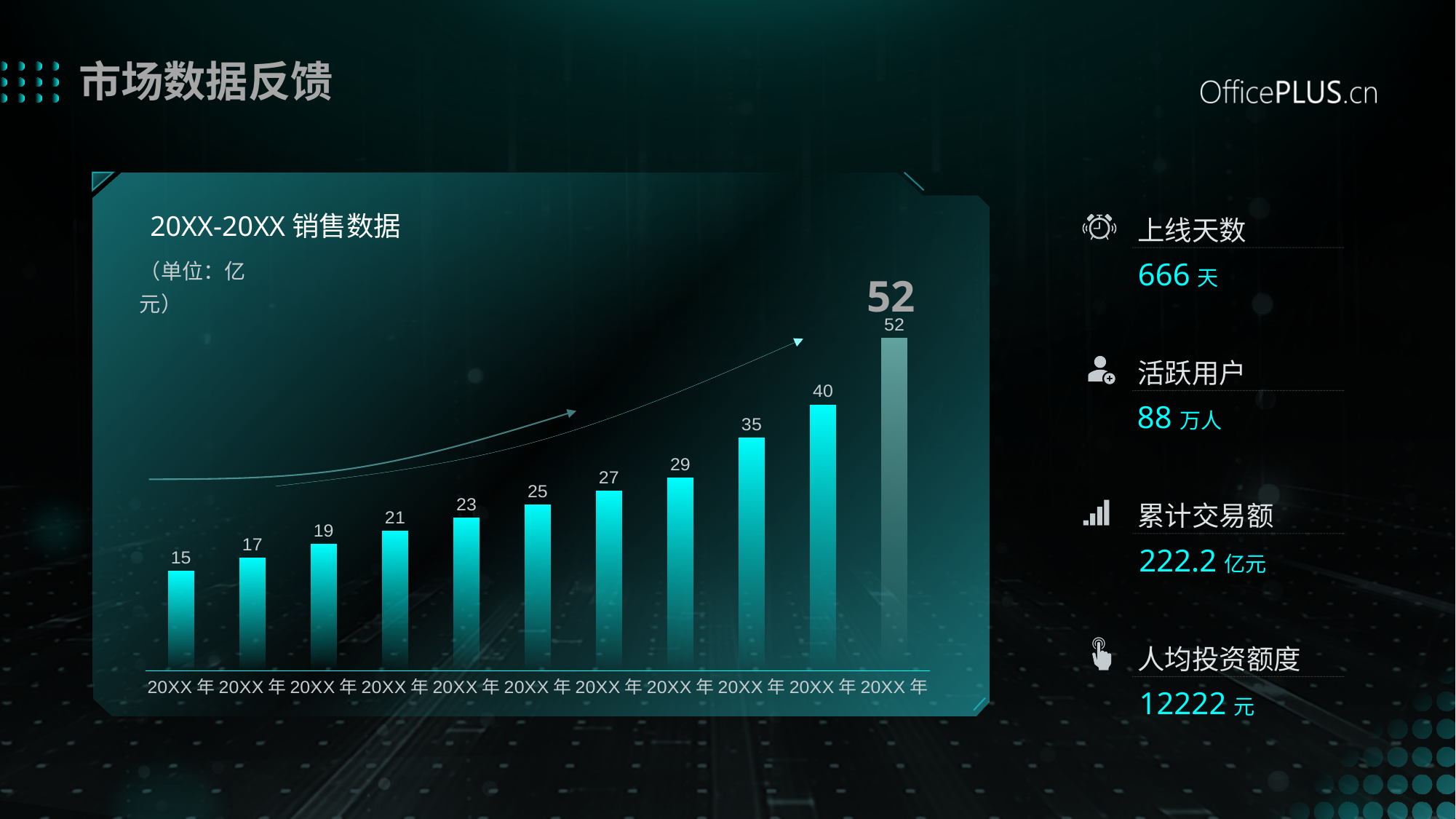
What type of chart is shown on the slide? bar chart How many bars does the chart contain? 11 What is the value of the last (rightmost) bar in the chart? 52 Do the values rise or fall from left to right along the x axis? rise What is the title of the chart? 20XX-20XX 销售数据 What is the highest value shown in the chart? 52 What unit is stated for the chart's values? 亿元 What is the value of the ninth bar from the left in the chart? 35 What is the value of the first (leftmost) bar in the chart? 15 Which is larger, the value of the tenth bar or the value of the ninth bar? the tenth bar (40) What is the difference between the last bar (52) and the second-to-last bar (40)? 12 What is the lowest value shown in the chart? 15